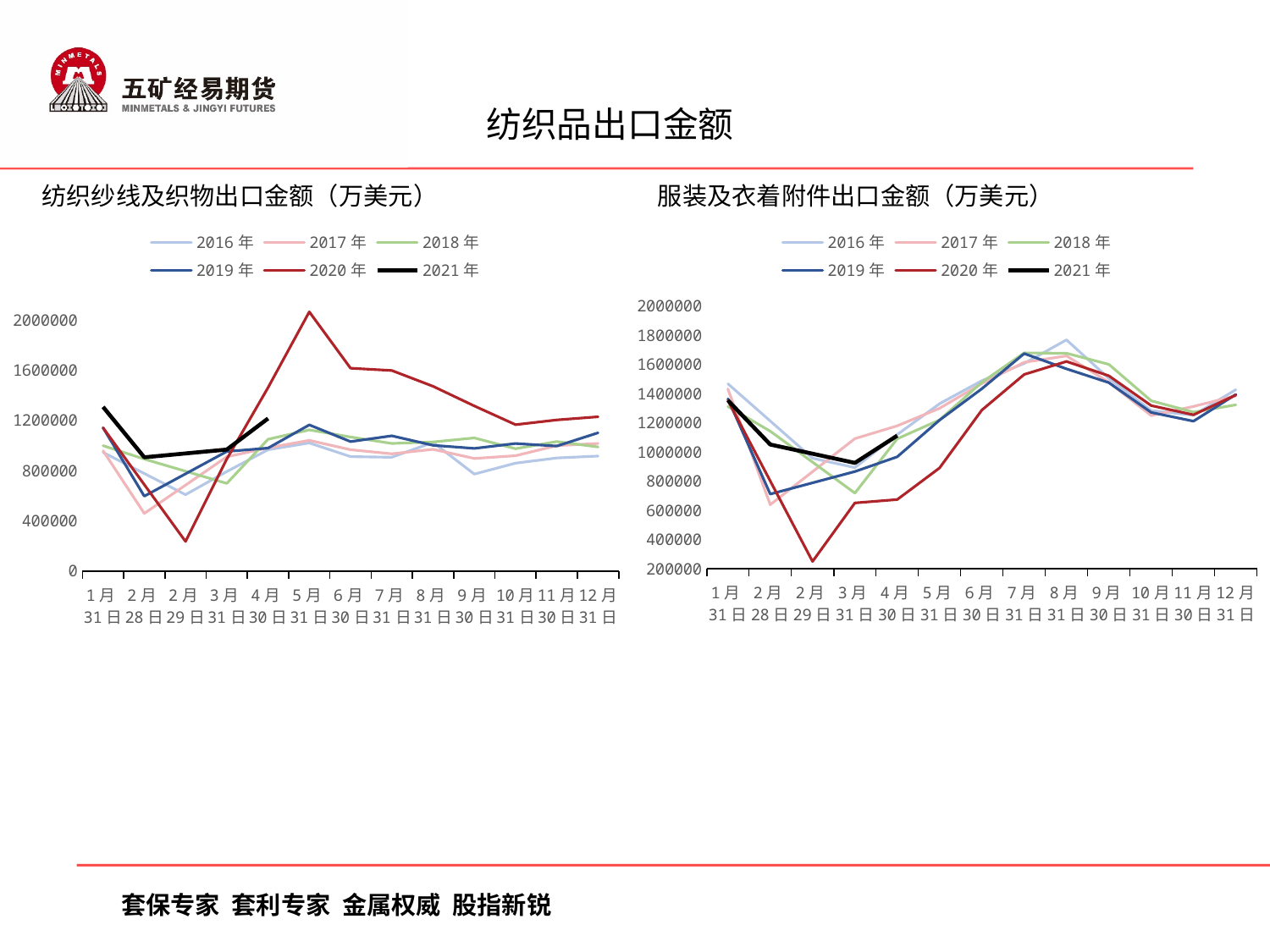
In the right chart, 服装及衣着附件出口金额（万美元）, does the 2020年 line rise or fall from 2月29日 to 7月31日? rise In the right chart, 服装及衣着附件出口金额（万美元）, is the value for 2020年 at 2月29日 greater or less than 400000? less In the left chart, 纺织纱线及织物出口金额（万美元）, which series reaches the highest point on the chart? 2020年 In the left chart, 纺织纱线及织物出口金额（万美元）, is the value for 2021年 at 1月31日 greater or less than 1200000? greater What colour is the 2021年 line in the legend of the left chart, 纺织纱线及织物出口金额（万美元）? black In the left chart, 纺织纱线及织物出口金额（万美元）, is the value for 2020年 at 5月31日 greater or less than 1600000? greater How many points are on the x axis of the left chart, 纺织纱线及织物出口金额（万美元）? 13 What kind of chart is the left chart, 纺织纱线及织物出口金额（万美元）? line chart How many series does the legend of the right chart, 服装及衣着附件出口金额（万美元）, list? 6 In the right chart, 服装及衣着附件出口金额（万美元）, which series has the lowest point on the chart? 2020年